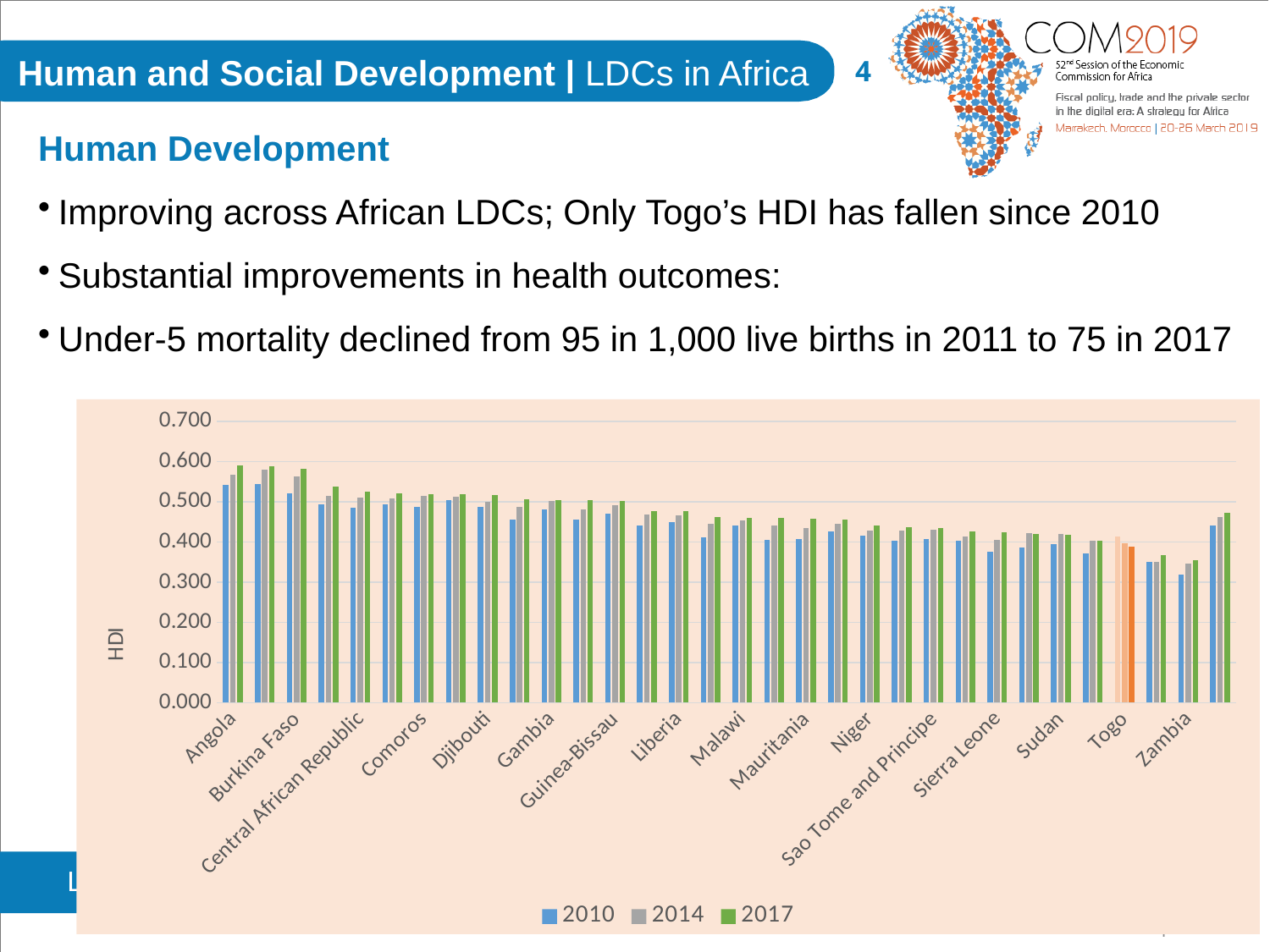
For Zambia, did the HDI value rise or fall from 2010 to 2017? rise Is the 2010 HDI value for Sierra Leone greater or less than 0.400? less For Togo, did the HDI value rise or fall from 2010 to 2017? fall Is the 2017 HDI value for Angola greater or less than 0.500? greater What is the label on the vertical axis of the chart? HDI Which country has the larger 2017 HDI value, Angola or Togo? Angola Which country has the larger 2010 HDI value, Angola or Zambia? Angola Is the 2010 HDI value for Malawi greater or less than 0.500? less How many series does the chart legend list? 3 What kind of chart is shown on the slide? bar chart Which years are listed in the chart legend? 2010, 2014, 2017